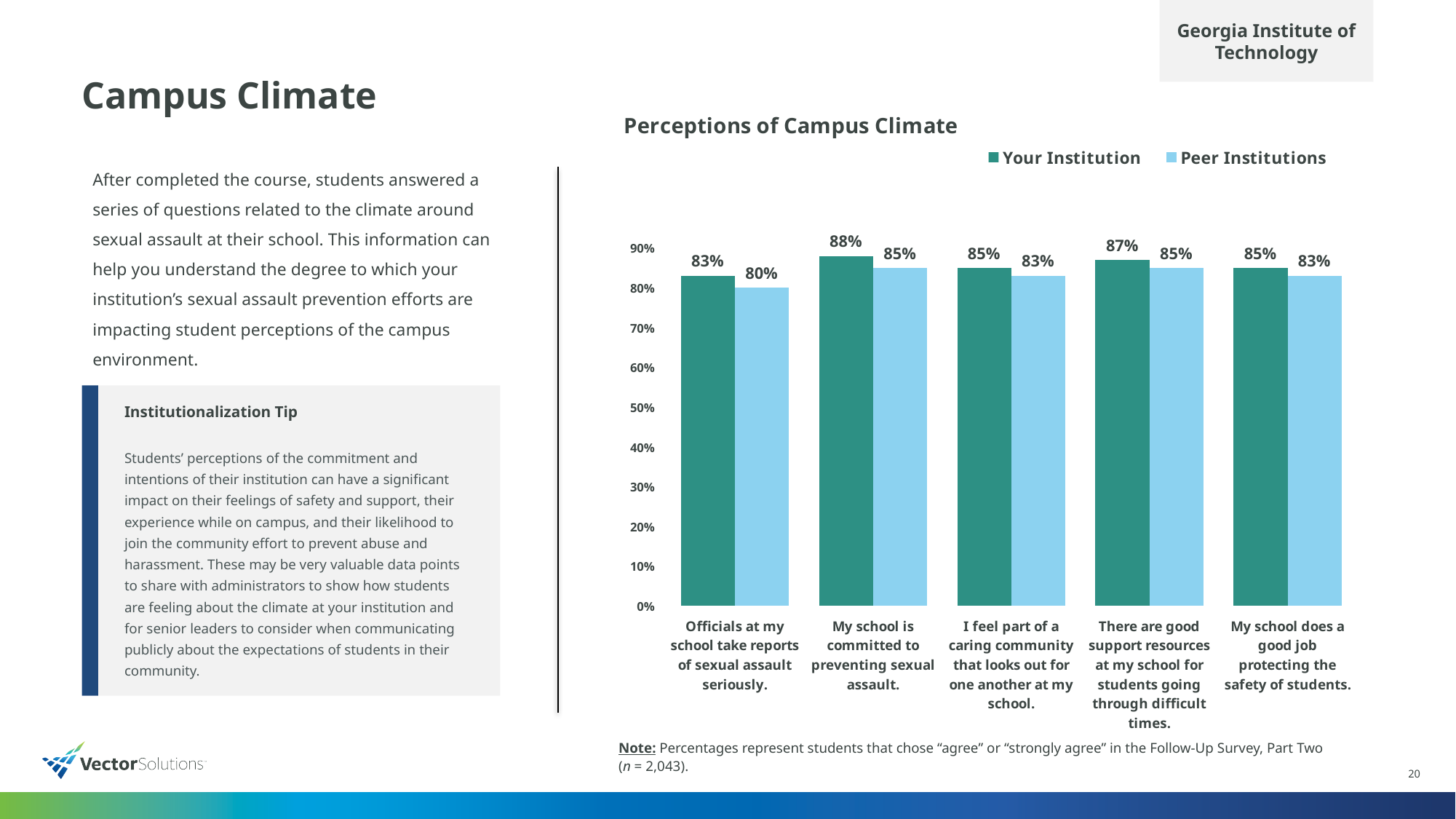
How many categories are shown on the x axis? 5 What is the Your Institution value for "My school is committed to preventing sexual assault."? 88% What is the Peer Institutions value for "There are good support resources at my school for students going through difficult times."? 85% Which category has the lowest Peer Institutions value? Officials at my school take reports of sexual assault seriously. What is the title of the chart? Perceptions of Campus Climate What is the difference between the Your Institution and Peer Institutions values for "Officials at my school take reports of sexual assault seriously."? 3% Which series is shown in light blue in the legend? Peer Institutions What kind of chart is shown on the slide? Bar chart What is the Peer Institutions value for "Officials at my school take reports of sexual assault seriously."? 80% Which category has the highest Your Institution value? My school is committed to preventing sexual assault. How many series does the legend list? 2 For "My school does a good job protecting the safety of students.", which is larger: Your Institution or Peer Institutions? Your Institution